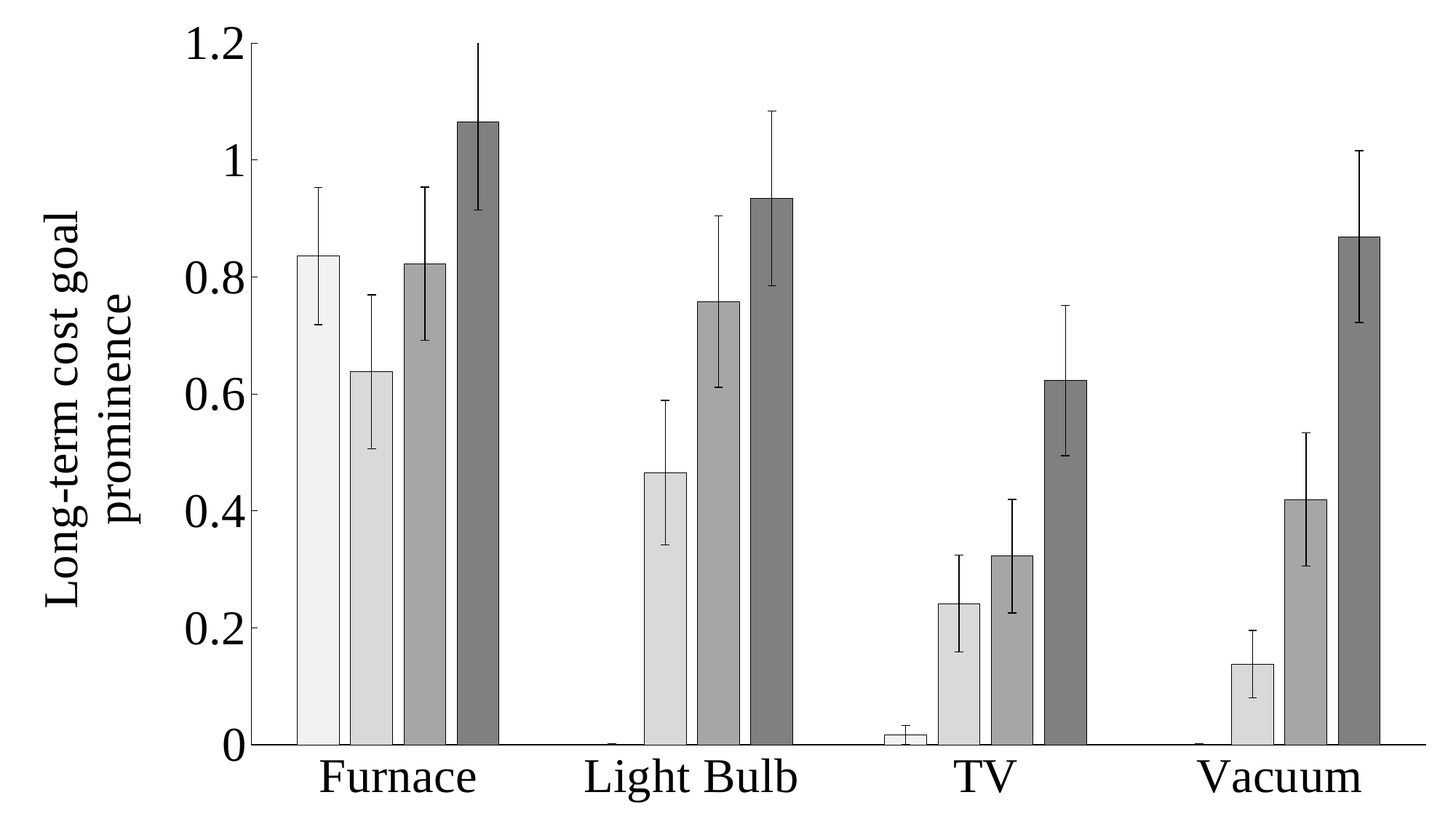
How many categories are shown on the x axis? 4 How many bars are plotted for each category? 4 Is the value of the darkest bar for TV greater or less than 0.8? less Is the value of the lightest (first) bar for Furnace greater or less than 0.6? greater Which category has the tallest darkest (fourth) bar? Furnace Is the value of the darkest bar for Furnace greater or less than 1? greater What kind of chart is shown on the slide? bar chart Which category has the shortest darkest (fourth) bar? TV For TV, which is taller: the third bar or the fourth bar? the fourth bar What is the highest tick value shown on the y axis? 1.2 What is the label of the y axis? Long-term cost goal prominence